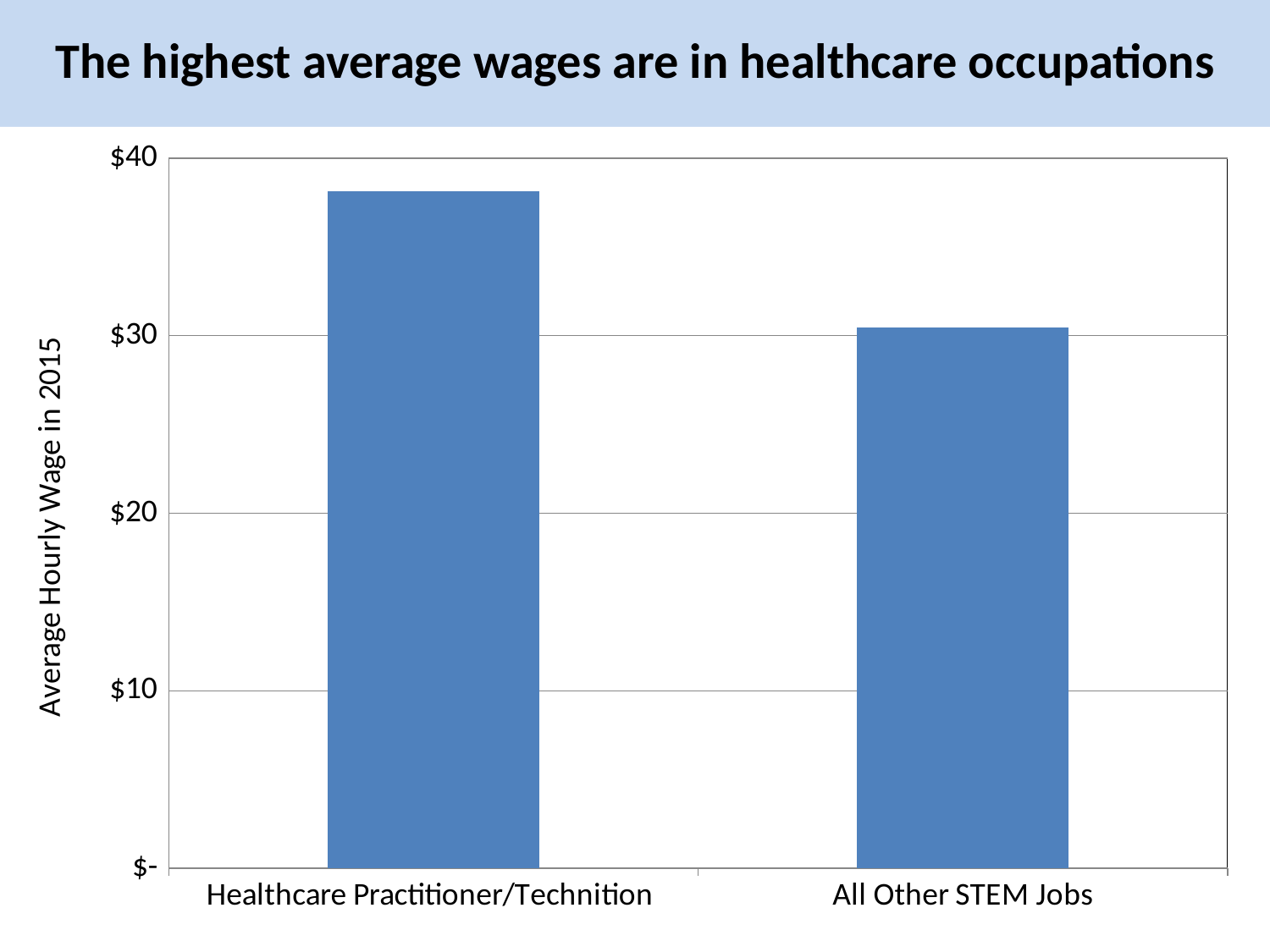
Which is larger, the average hourly wage for Healthcare Practitioner/Technition or for All Other STEM Jobs? Healthcare Practitioner/Technition What is the label on the vertical axis of the chart? Average Hourly Wage in 2015 How many categories are plotted in the chart? 2 Is the value for All Other STEM Jobs greater or less than $20? greater Is the value for Healthcare Practitioner/Technition greater or less than $30? greater What is the title of the slide? The highest average wages are in healthcare occupations Which category has the lowest average hourly wage? All Other STEM Jobs Which category has the highest average hourly wage? Healthcare Practitioner/Technition Is the value for Healthcare Practitioner/Technition greater or less than $40? less What kind of chart is shown on the slide? bar chart